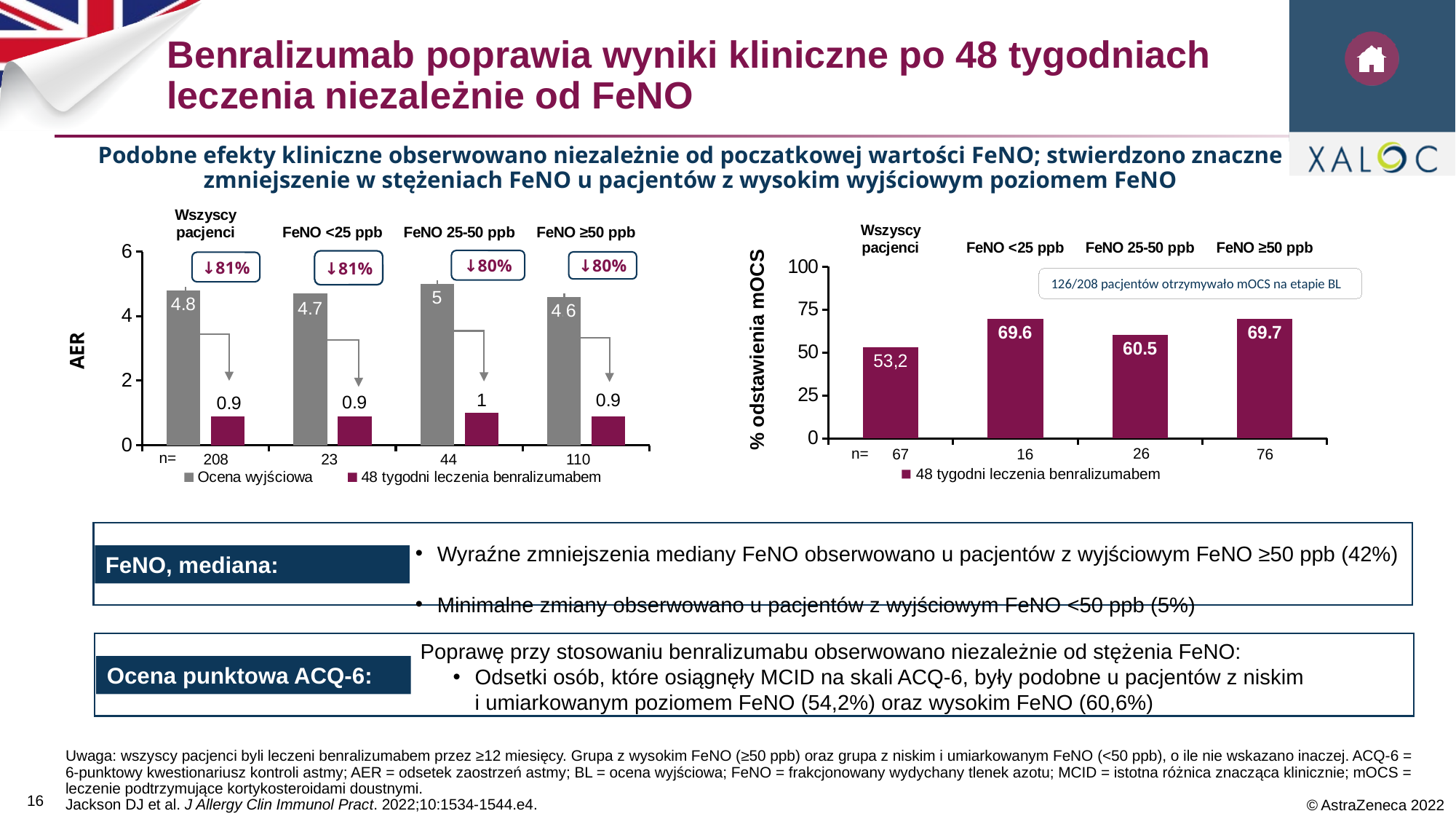
In the left AER chart, what is the n for the FeNO ≥50 ppb group? 110 In the left AER chart, how many series does the legend list? 2 In the right chart (% odstawienia mOCS), which is larger: the value for FeNO <25 ppb or for FeNO 25-50 ppb? FeNO <25 ppb What kind of chart is the right chart (% odstawienia mOCS)? bar chart In the left AER chart, what is the baseline AER value for the FeNO <25 ppb group? 4.7 In the left AER chart, what is the difference between the baseline and 48-week AER values for Wszyscy pacjenci? 3.9 In the right chart (% odstawienia mOCS), is the value for FeNO 25-50 ppb greater or less than 75? less In the left AER chart, what is the AER value after 48 weeks of benralizumab treatment for the FeNO 25-50 ppb group? 1 In the left AER chart, what percentage reduction is shown for the FeNO ≥50 ppb group? ↓80% In the left AER chart, what is the baseline (Ocena wyjściowa) AER value for Wszyscy pacjenci? 4.8 In the right chart (% odstawienia mOCS), what is the value for Wszyscy pacjenci? 53,2 In the right chart (% odstawienia mOCS), which group has the lowest value? Wszyscy pacjenci